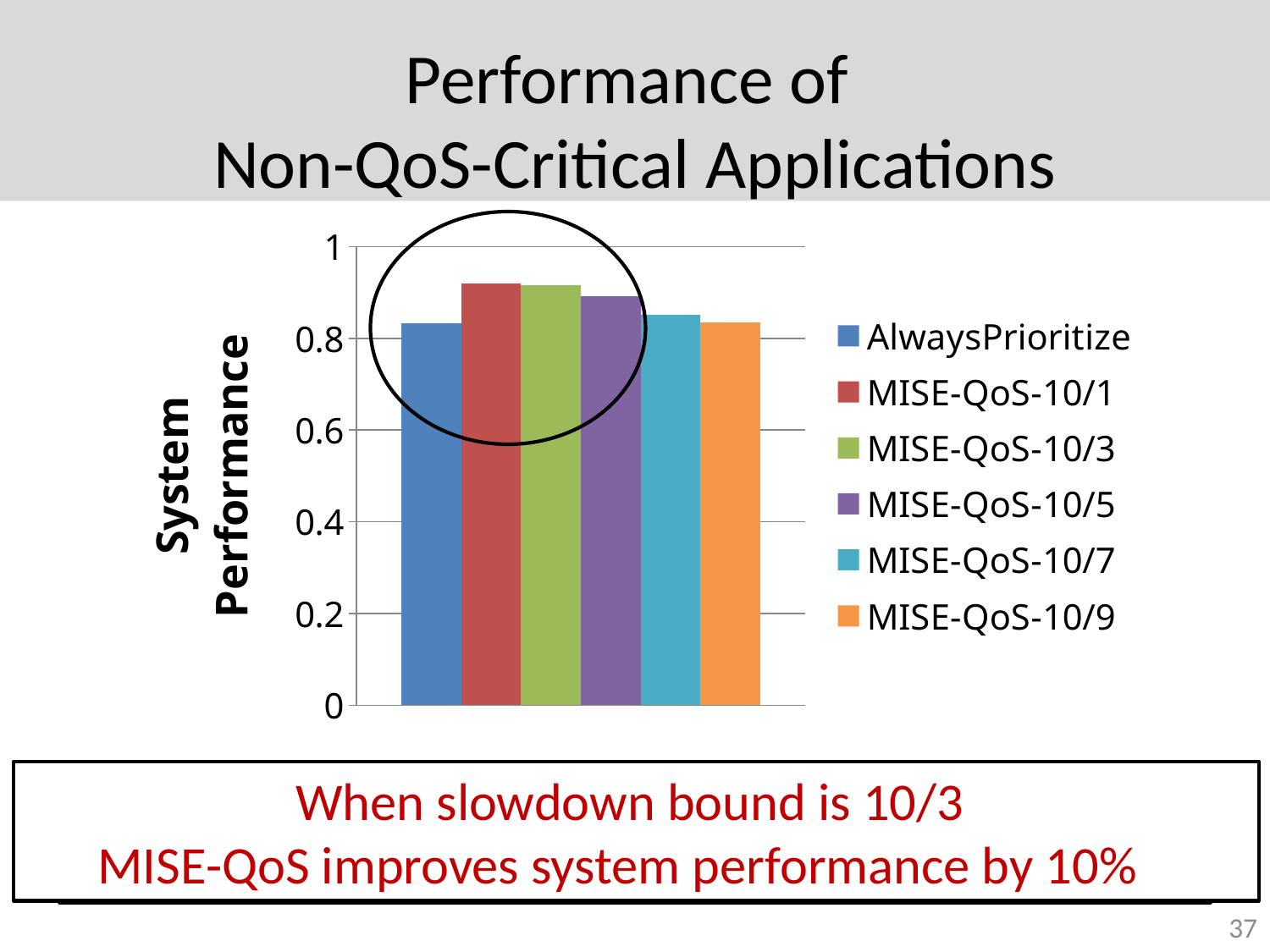
Which is larger, the value for MISE-QoS-10/5 or the value for AlwaysPrioritize? MISE-QoS-10/5 Which is larger, the value for MISE-QoS-10/3 or the value for MISE-QoS-10/9? MISE-QoS-10/3 What is the label on the chart's vertical axis? System Performance Is the value for MISE-QoS-10/9 greater or less than 1? less How many series does the chart's legend list? 6 Is the value for MISE-QoS-10/7 greater or less than 0.6? greater Is the value for AlwaysPrioritize greater or less than 0.8? greater What kind of chart is shown on the slide? bar chart Which is larger, the value for MISE-QoS-10/1 or the value for MISE-QoS-10/7? MISE-QoS-10/1 What colour is the bar for AlwaysPrioritize in the chart? blue